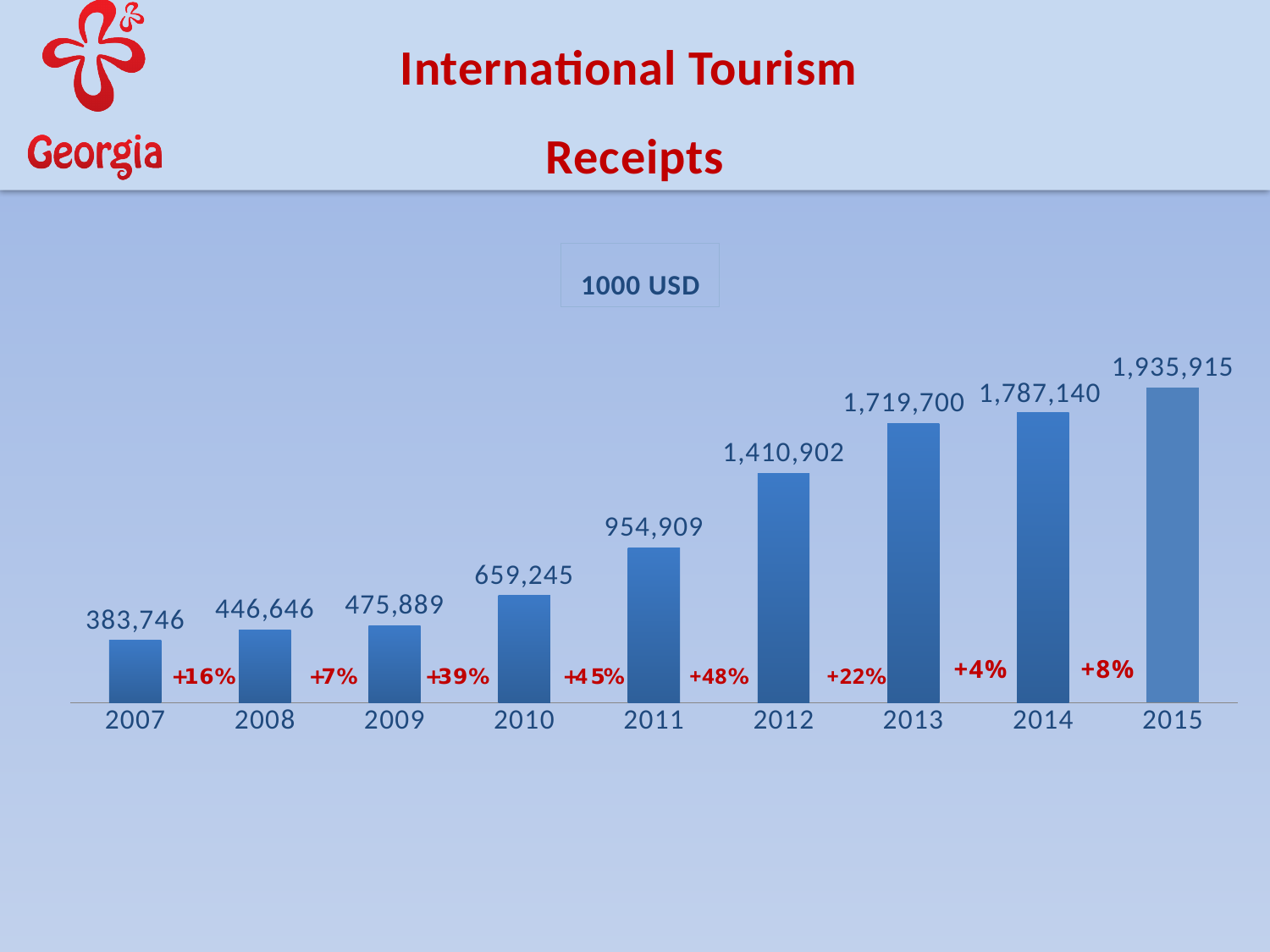
What is the difference between the values for 2015 and 2014? 148,775 Which is larger, the value for 2009 or the value for 2010? 2010 What unit is shown in the legend box above the chart? 1000 USD Do the values rise or fall from 2007 to 2015? rise Which year has the lowest value? 2007 How many years are shown on the x axis? 9 What is the value for 2014? 1,787,140 What is the value for 2007? 383,746 What is the difference between the values for 2012 and 2011? 455,993 Which year has the highest value? 2015 What is the value for 2011? 954,909 What kind of chart is this? bar chart